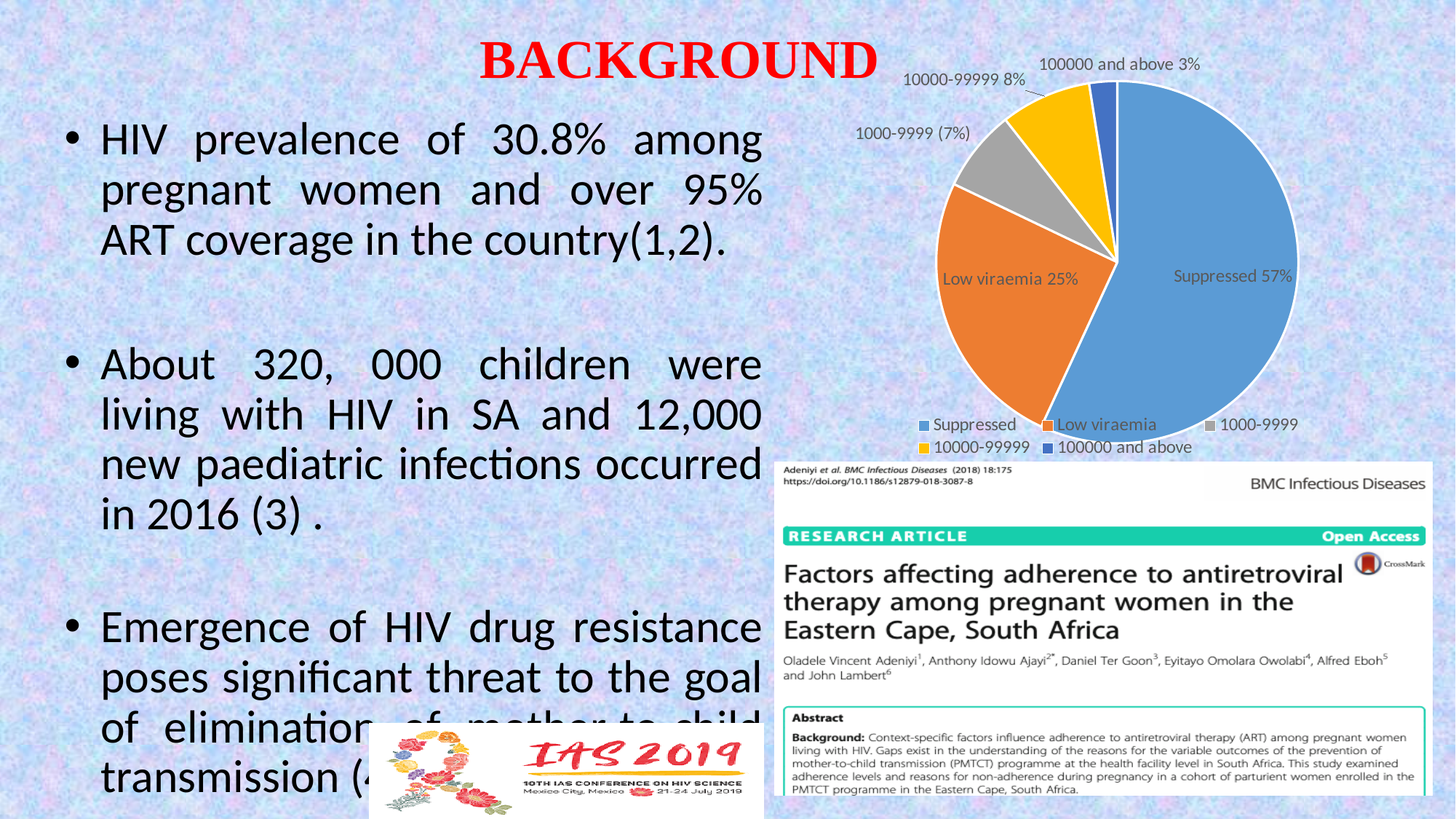
What type of chart is shown on the slide? pie chart What is the difference in percentage points between the Suppressed and Low viraemia slices? 32 What share of the pie is labelled Low viraemia? 25% What share of the pie is labelled 1000-9999? 7% Which slice is larger, 10000-99999 or 1000-9999? 10000-99999 Which category has the smallest slice of the pie? 100000 and above What share of the pie is labelled 100000 and above? 3% What colour is the Low viraemia slice of the pie chart? orange What share of the pie is labelled 10000-99999? 8% How many categories does the legend of the pie chart list? 5 What share of the pie is labelled Suppressed? 57% Which category has the largest slice of the pie? Suppressed